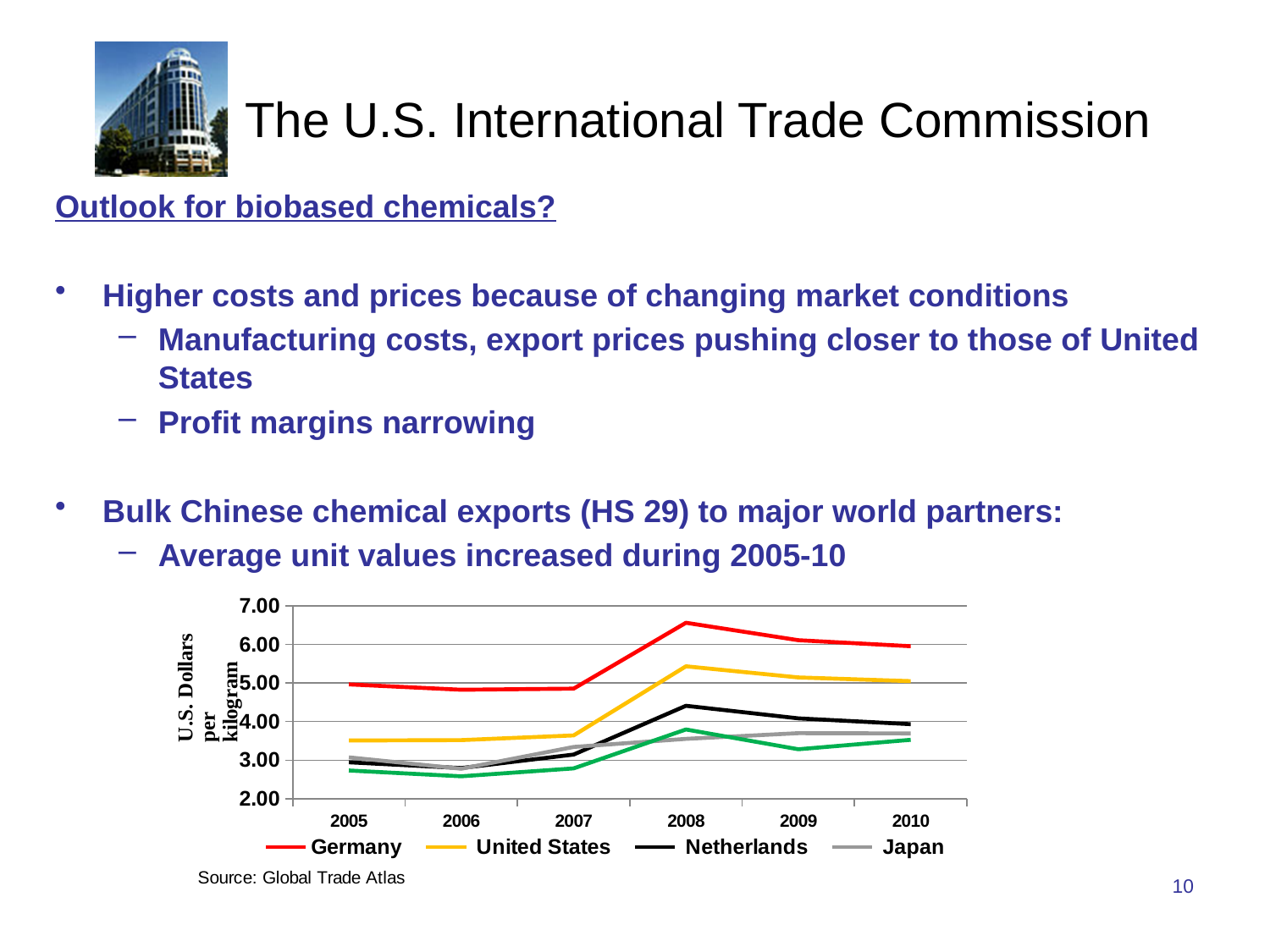
How many series does the chart legend list? 4 How many years are shown along the x axis of the chart? 6 What kind of chart is shown on the slide? line chart Does the Germany line rise or fall between 2007 and 2008? rise Which is larger in 2010, the value for Germany or the value for United States? Germany Is the value for United States in 2005 greater or less than 4.00? less Is the value for Germany in 2008 greater or less than 6.00? greater Is the value for United States in 2008 greater or less than 5.00? greater Which is larger in 2008, the value for Netherlands or the value for Japan? Netherlands Which series has the highest value in 2008? Germany